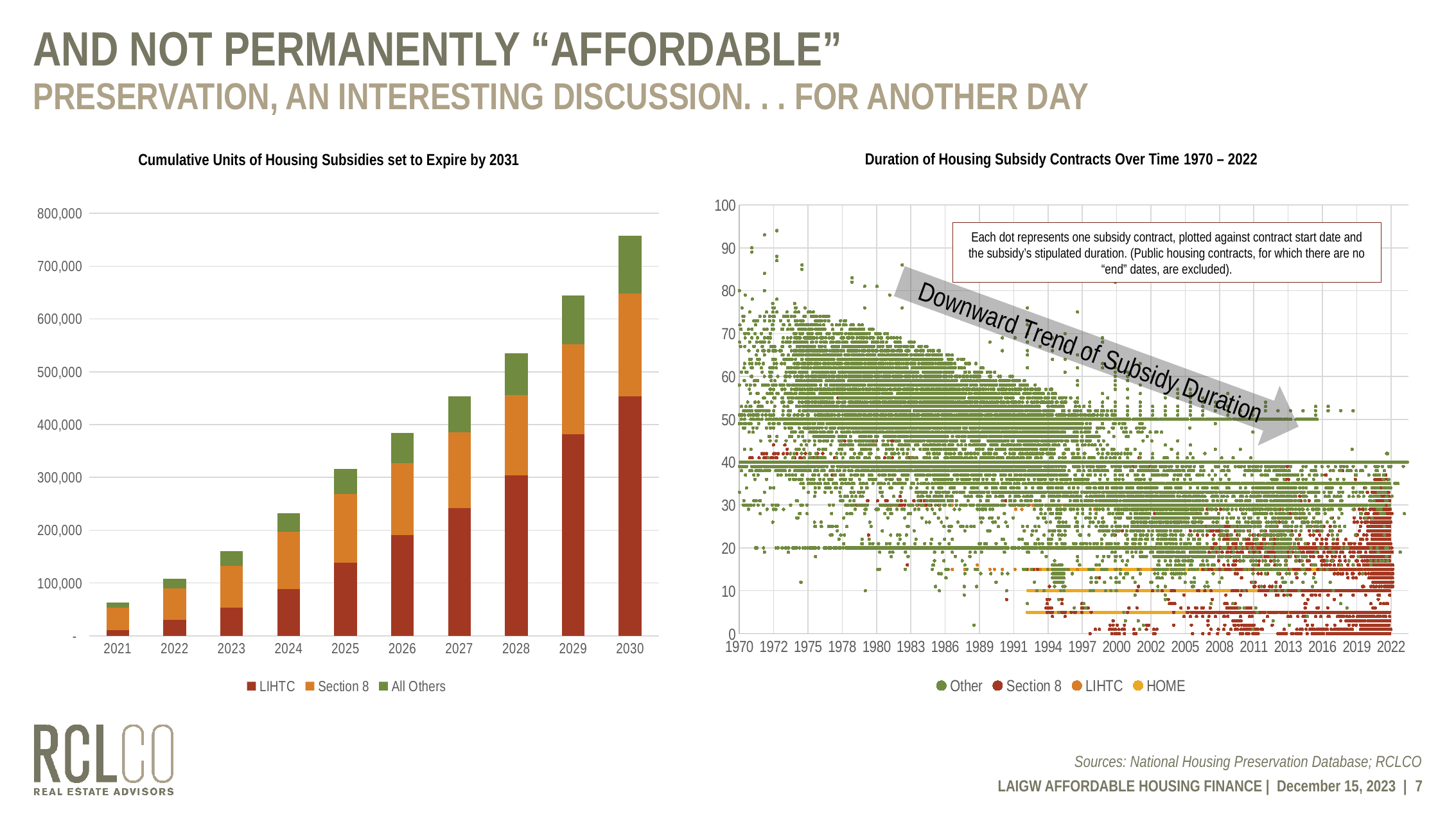
In the left chart, 'Cumulative Units of Housing Subsidies set to Expire by 2031', do the stacked bar totals rise or fall from 2021 to 2030? Rise In the left chart, 'Cumulative Units of Housing Subsidies set to Expire by 2031', is the total for 2021 greater or less than 100,000? less In the left chart, 'Cumulative Units of Housing Subsidies set to Expire by 2031', which is larger, the total for 2027 or the total for 2029? 2029 In the left chart, 'Cumulative Units of Housing Subsidies set to Expire by 2031', is the total for 2030 greater or less than 700,000? greater What type of chart is the right chart, 'Duration of Housing Subsidy Contracts Over Time 1970 – 2022'? Scatter chart What type of chart is the left chart, 'Cumulative Units of Housing Subsidies set to Expire by 2031'? Stacked bar chart In the right chart, 'Duration of Housing Subsidy Contracts Over Time 1970 – 2022', how many series does the legend list? 4 In the left chart, 'Cumulative Units of Housing Subsidies set to Expire by 2031', which year has the shortest stacked bar? 2021 In the left chart, 'Cumulative Units of Housing Subsidies set to Expire by 2031', is the total for 2028 greater or less than 500,000? greater In the left chart, 'Cumulative Units of Housing Subsidies set to Expire by 2031', how many years are shown on the x axis? 10 In the left chart, 'Cumulative Units of Housing Subsidies set to Expire by 2031', which year has the tallest stacked bar? 2030 In the left chart, 'Cumulative Units of Housing Subsidies set to Expire by 2031', how many series does the legend list? 3